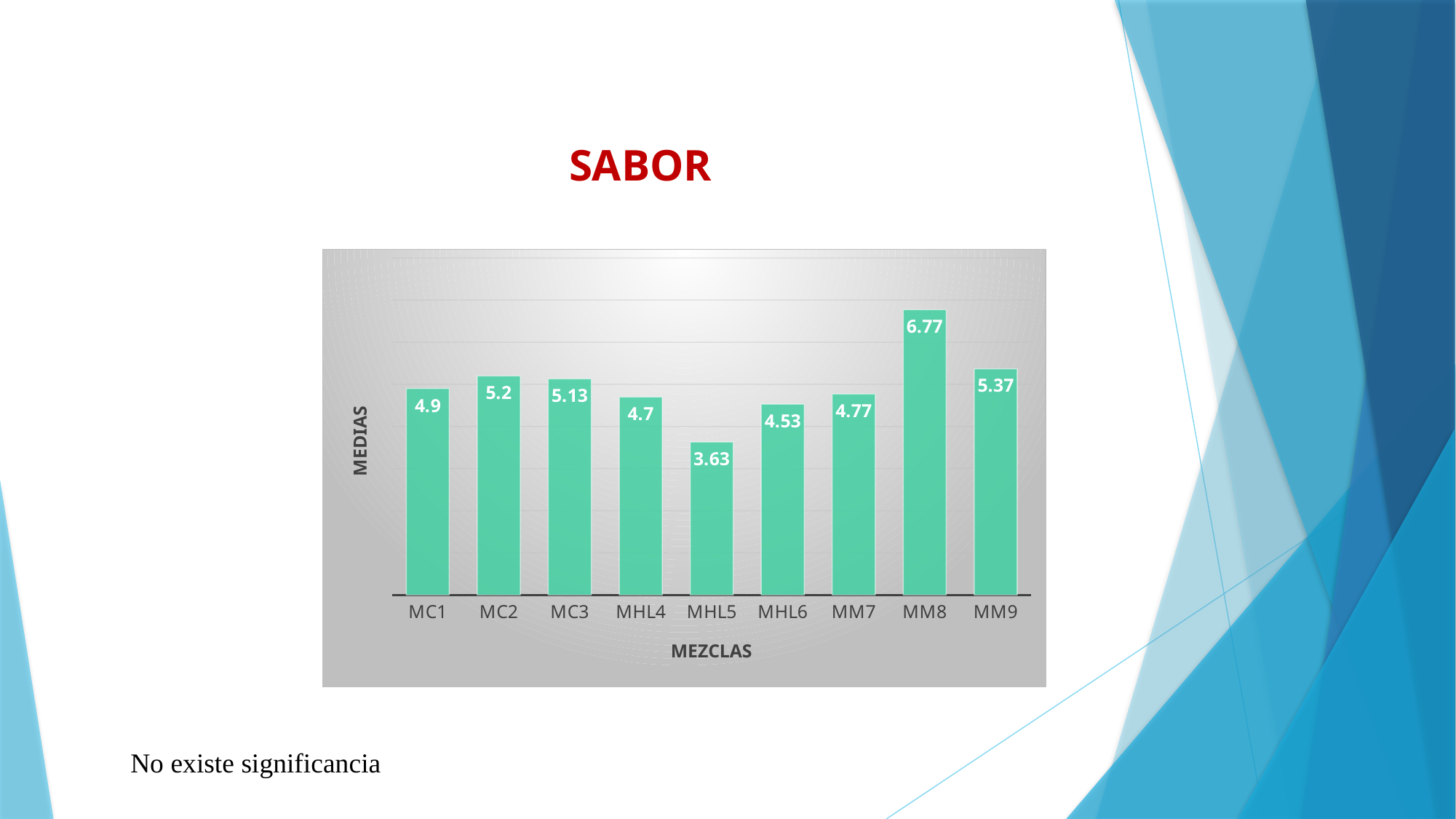
Which mezcla has the lowest value? MHL5 Which mezcla has the highest value? MM8 How many mezclas are shown on the x axis? 9 What is the label of the x axis? MEZCLAS What is the value for MC2? 5.2 What is the value for MM8? 6.77 What is the title of the chart? SABOR What is the difference between the values for MM8 and MHL5? 3.14 What is the value for MHL5? 3.63 What is the difference between the values for MC3 and MHL4? 0.43 What kind of chart is shown on the slide? bar chart Which is larger, the value for MM9 or the value for MC1? MM9